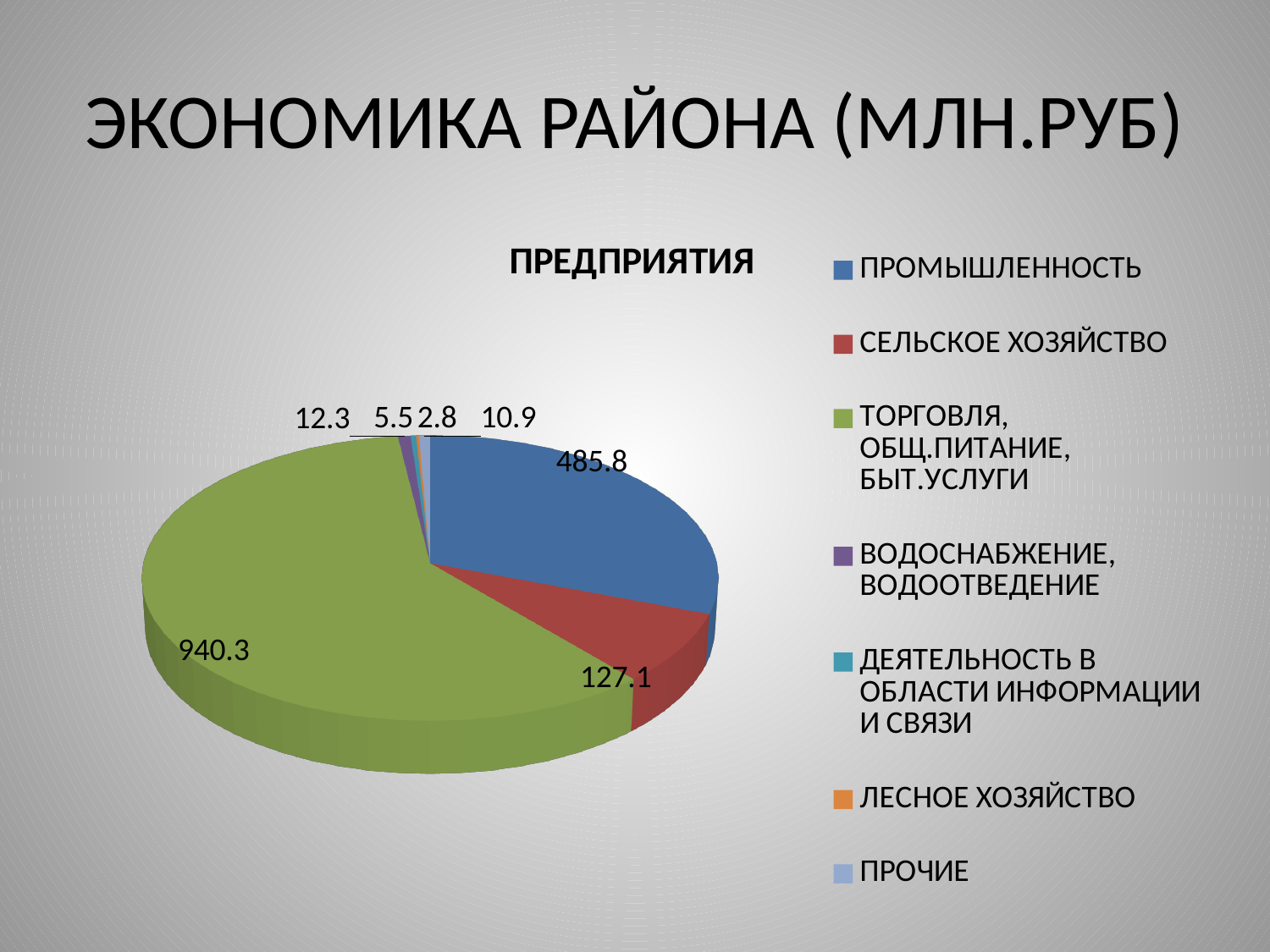
What is the value for СЕЛЬСКОЕ ХОЗЯЙСТВО? 127.1 What is the title of the chart? ПРЕДПРИЯТИЯ Which category has the smallest slice of the pie? ЛЕСНОЕ ХОЗЯЙСТВО What type of chart is shown on the slide? Pie chart What colour is the slice for ПРОМЫШЛЕННОСТЬ? Blue Which category has the largest slice of the pie? ТОРГОВЛЯ, ОБЩ.ПИТАНИЕ, БЫТ.УСЛУГИ Which is larger, the value for ПРОМЫШЛЕННОСТЬ or the value for СЕЛЬСКОЕ ХОЗЯЙСТВО? ПРОМЫШЛЕННОСТЬ What is the value for ПРОМЫШЛЕННОСТЬ? 485.8 What is the value for ЛЕСНОЕ ХОЗЯЙСТВО? 2.8 What is the value for ТОРГОВЛЯ, ОБЩ.ПИТАНИЕ, БЫТ.УСЛУГИ? 940.3 What is the difference between the values for ТОРГОВЛЯ, ОБЩ.ПИТАНИЕ, БЫТ.УСЛУГИ and ПРОМЫШЛЕННОСТЬ? 454.5 How many categories does the legend of the pie chart list? 7